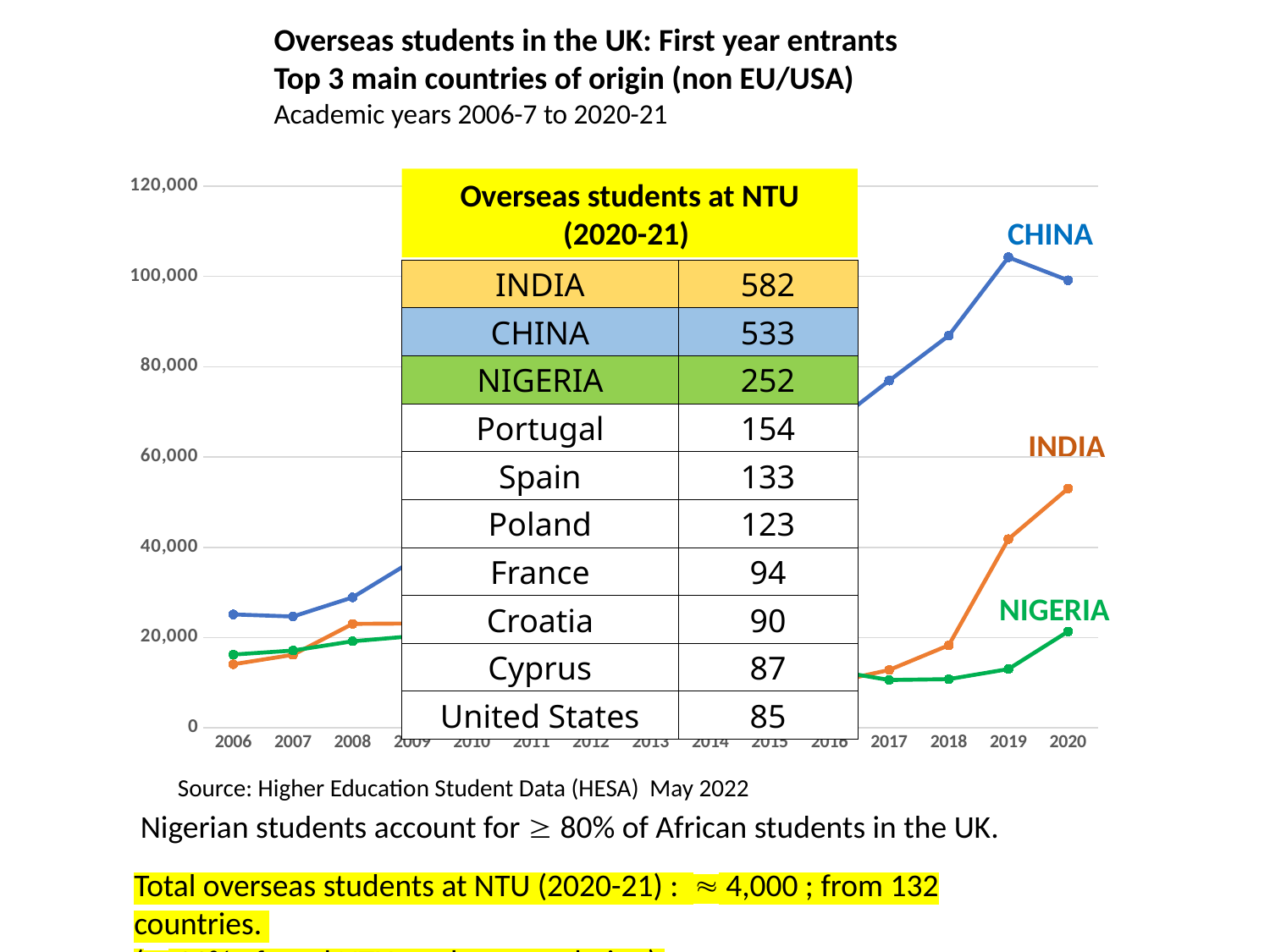
How many countries are plotted as series on the chart? 3 Is the value for India in 2006 greater or less than 20,000? less Which country has the lowest number of first year entrants in 2020? Nigeria Is the value for China in 2020 greater or less than 80,000? greater Does the value for India rise or fall between 2017 and 2020? rise What is the source cited below the chart? Higher Education Student Data (HESA) May 2022 In 2020, which is larger: the value for China or the value for India? China Is the value for Nigeria in 2020 greater or less than 40,000? less What kind of chart is shown on the slide? line chart Which country has the highest number of first year entrants in 2020? China